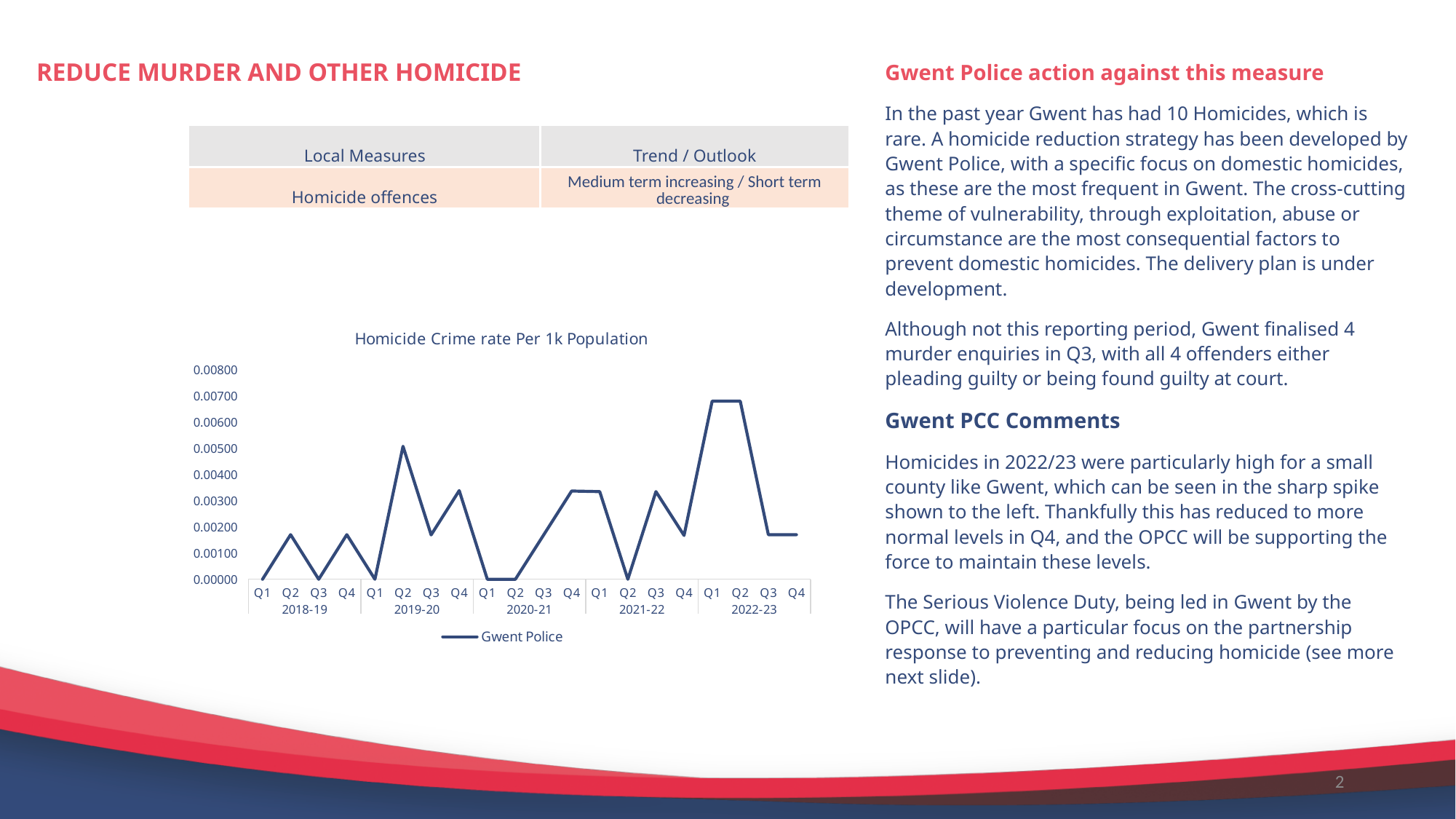
What is the title of the chart? Homicide Crime rate Per 1k Population Is the value for Q2 2019-20 greater or less than 0.00400? greater Is the value for Q1 2022-23 greater or less than 0.00600? greater How many quarterly data points are plotted on the chart? 20 How many series does the chart legend list? 1 What is the value for Q2 2020-21? 0.00000 What is the name of the series shown in the chart legend? Gwent Police What kind of chart is shown on the slide? line chart Does the value rise or fall from Q2 2022-23 to Q3 2022-23? fall Which is larger, the value for Q2 2019-20 or the value for Q4 2019-20? Q2 2019-20 What is the value for Q1 2018-19? 0.00000